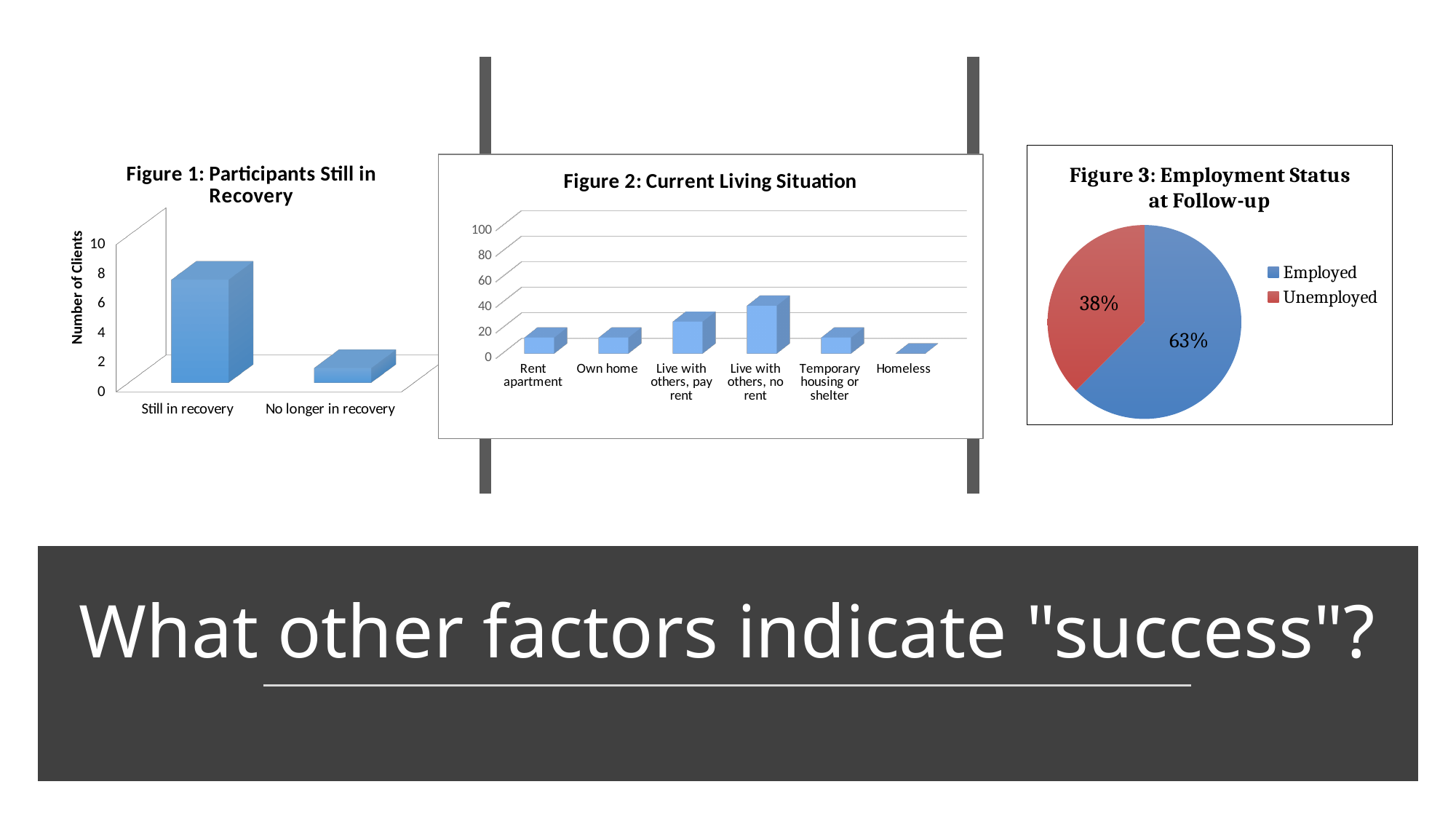
In Figure 1: Participants Still in Recovery, is the value for Still in recovery greater or less than 6? greater In Figure 1: Participants Still in Recovery, is the value for No longer in recovery greater or less than 2? less In Figure 3: Employment Status at Follow-up, what is the value for Unemployed? 38% In Figure 3: Employment Status at Follow-up, what share of participants are Employed? 63% In Figure 1: Participants Still in Recovery, which category has the higher value? Still in recovery How many categories are shown in Figure 2: Current Living Situation? 6 What kind of chart is Figure 3: Employment Status at Follow-up? pie chart In Figure 2: Current Living Situation, is the value for Live with others, no rent greater or less than 20? greater In Figure 1: Participants Still in Recovery, what is the y-axis label? Number of Clients In Figure 2: Current Living Situation, which category has the lowest value? Homeless In Figure 2: Current Living Situation, which category has the highest value? Live with others, no rent What kind of chart is Figure 2: Current Living Situation? bar chart